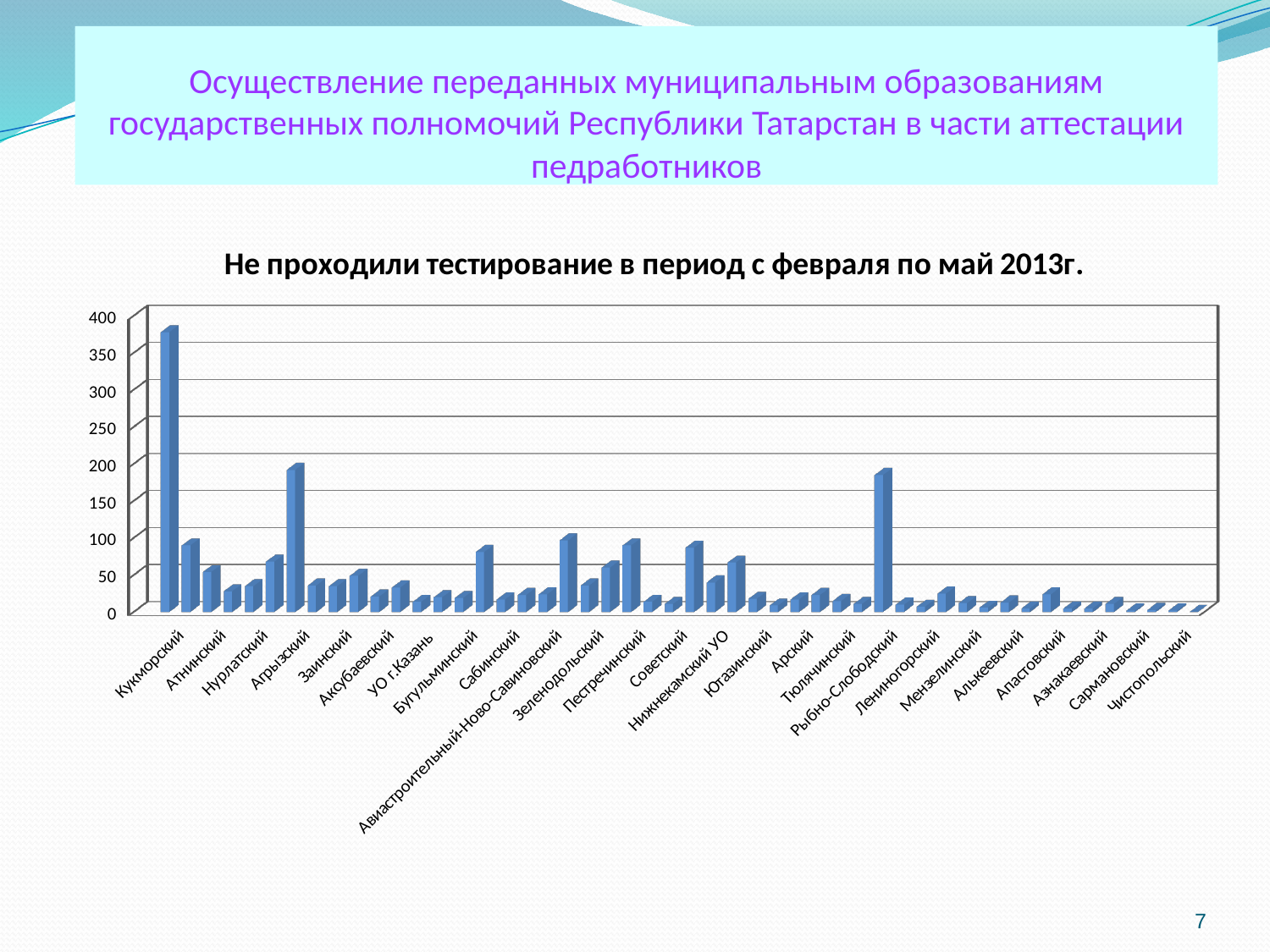
Which is larger, the value for Кукморский or the value for Рыбно-Слободский? Кукморский Is the value for Рыбно-Слободский greater or less than 250? less Is the value for Агрызский greater or less than 250? less What is the title of the chart? Не проходили тестирование в период с февраля по май 2013г. Is the value for Кукморский greater or less than 350? less What kind of chart is shown on the slide? bar chart Which is larger, the value for Кукморский or the value for Атнинский? Кукморский What is the maximum value shown on the vertical axis of the chart? 400